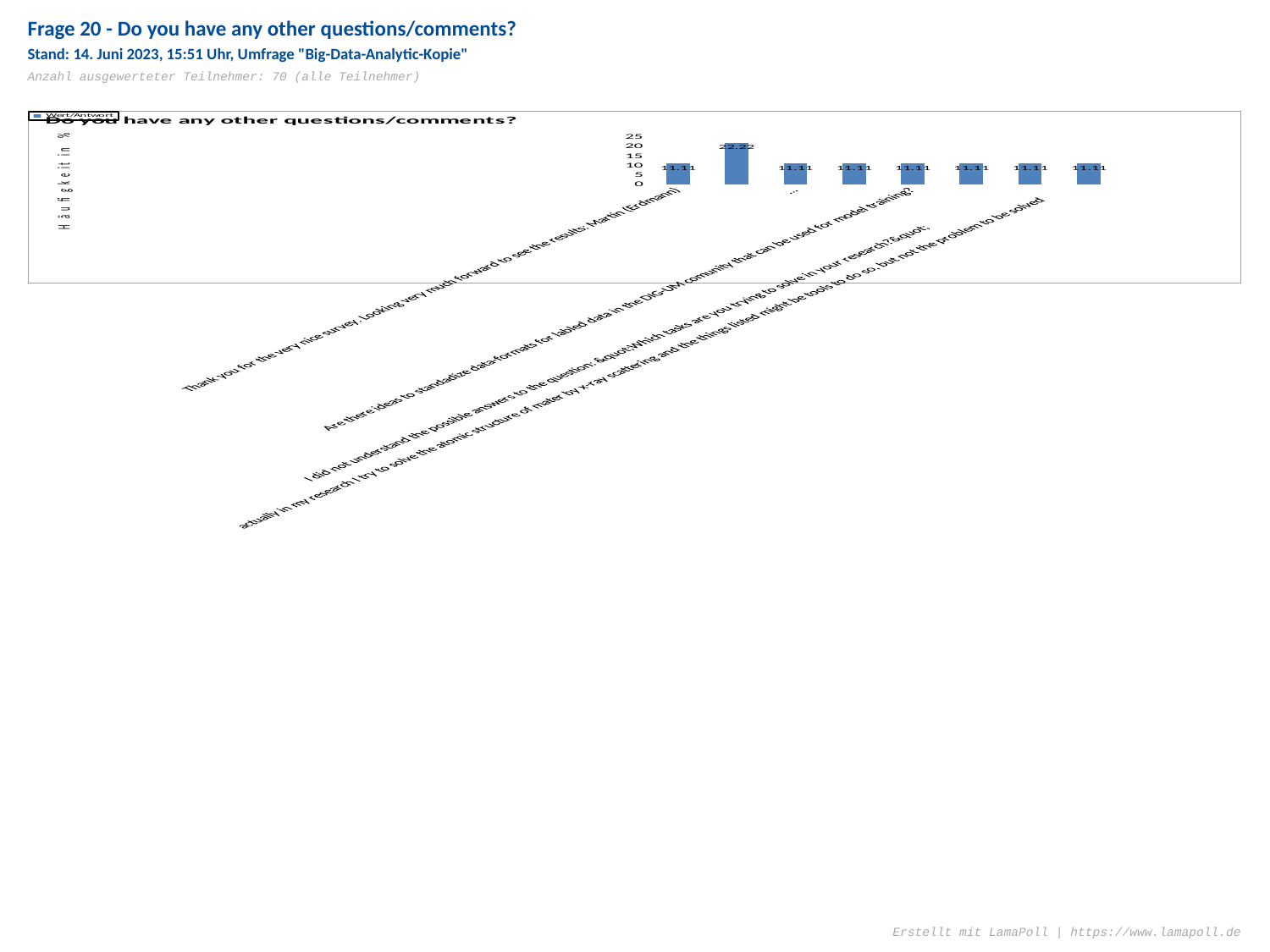
What is the highest value shown in the chart? 22.22 How many series does the legend list? 1 What is the title of the chart? Do you have any other questions/comments? What is the difference between the highest bar value (22.22) and the value of the leftmost bar (11.11)? 11.11 Which bar, by position from the left, has the highest value? the second bar What is the value of the leftmost bar, labelled 'Thank you for the very nice survey. Looking very much forward to see the results, Martin (Erdmann)'? 11.11 How many bars have the value 11.11? 7 Is the value of the tallest bar greater or less than 20? greater Which is larger, the value of the first bar from the left or the value of the second bar from the left? the second bar What kind of chart is shown on the slide? bar chart What is the label of the y axis? Häufigkeit in % How many bars are plotted in the chart? 8